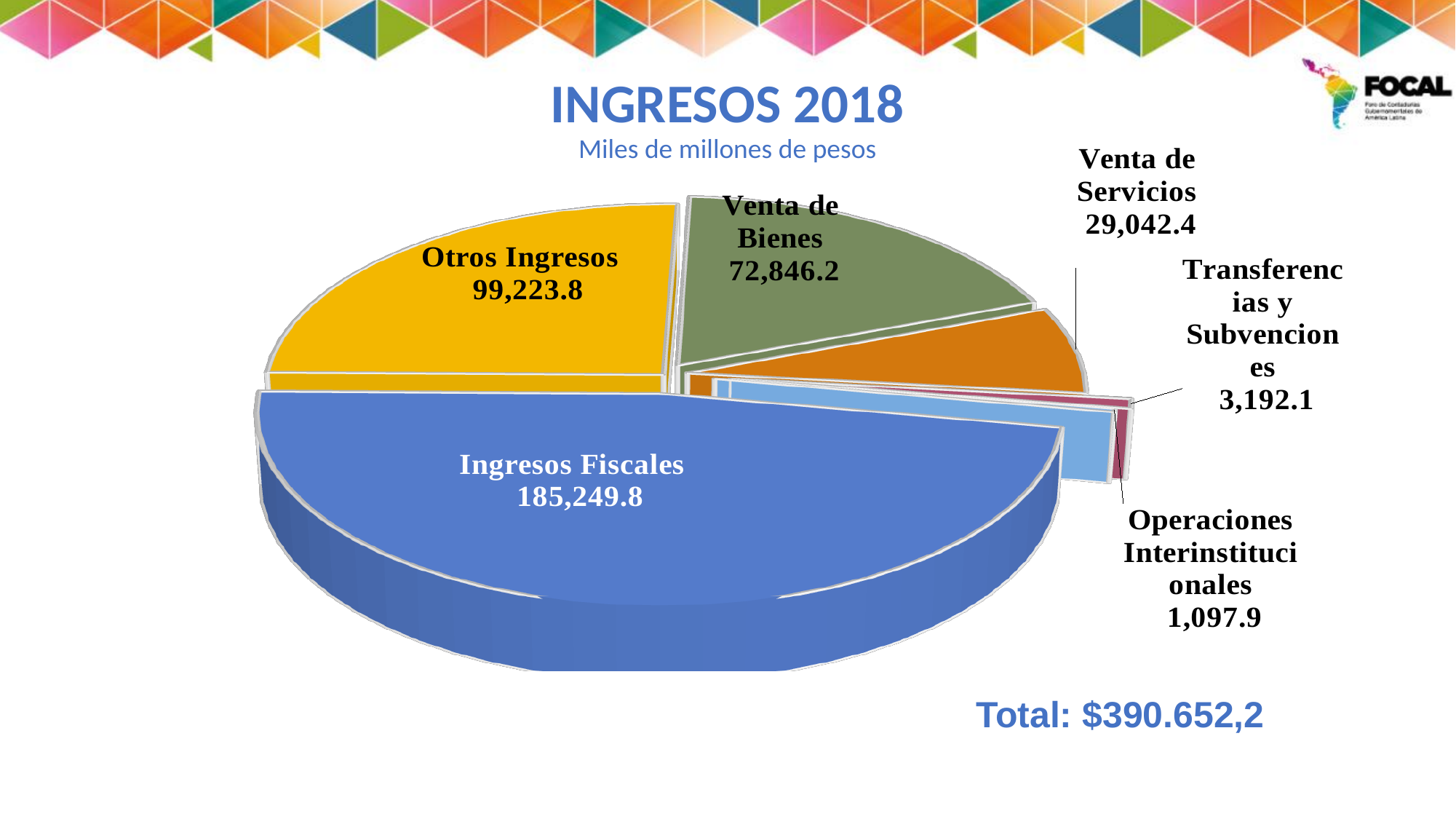
How many slices does the pie chart have? 6 Which category has the largest slice of the pie? Ingresos Fiscales What is the value for Transferencias y Subvenciones? 3,192.1 What is the value for Venta de Servicios? 29,042.4 What kind of chart is shown on the slide? Pie chart Which is larger, Venta de Bienes or Venta de Servicios? Venta de Bienes What is the value for Ingresos Fiscales? 185,249.8 What is the difference between Ingresos Fiscales and Otros Ingresos? 86,026.0 Which category has the smallest slice of the pie? Operaciones Interinstitucionales What total is printed on the slide for the pie chart? $390.652,2 What is the value for Otros Ingresos? 99,223.8 In what units are the values of the chart expressed, according to the subtitle? Miles de millones de pesos